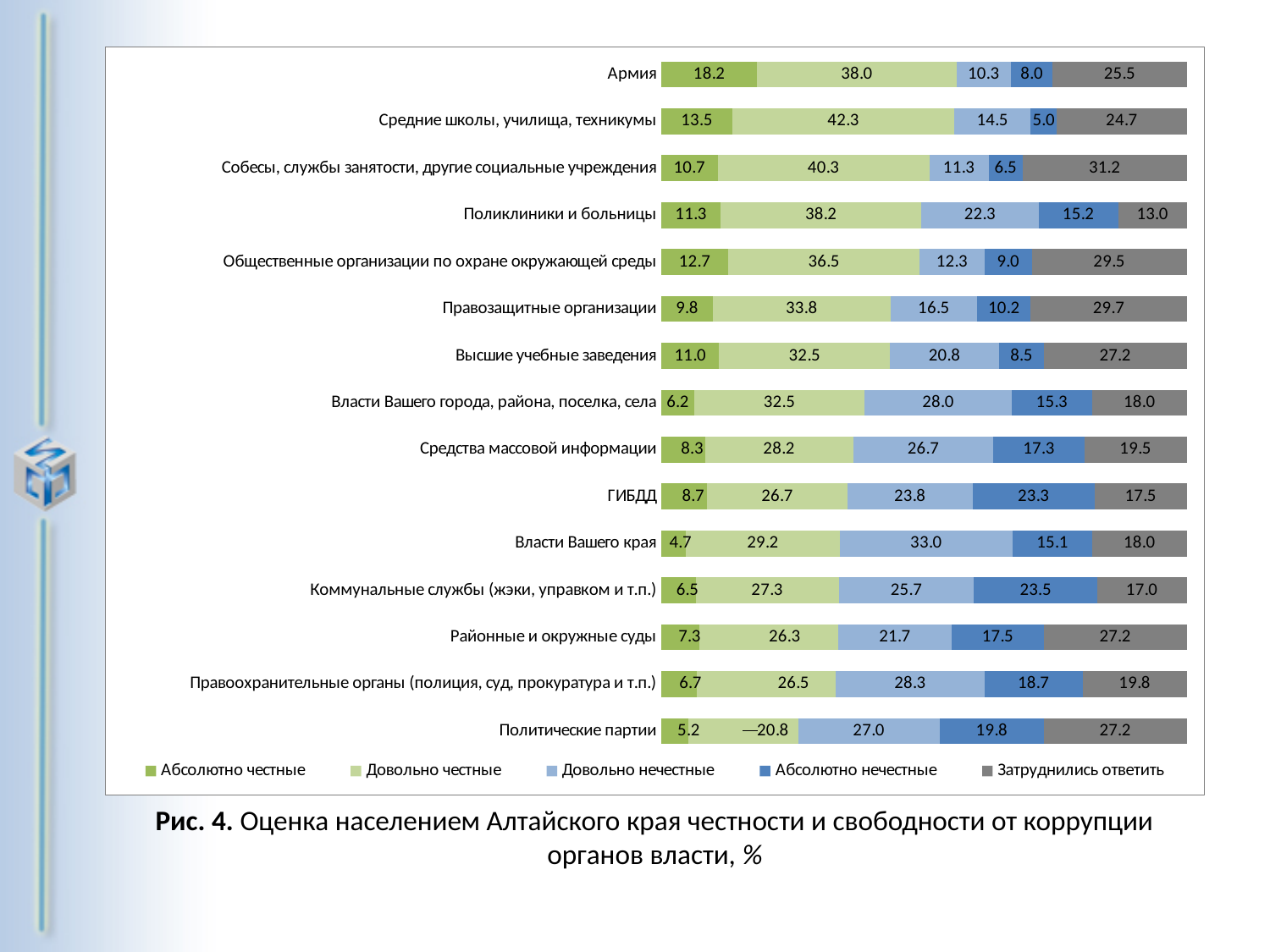
What is the value of 'Довольно нечестные' for Власти Вашего края? 33.0 What is the value of 'Затруднились ответить' for Поликлиники и больницы? 13.0 What kind of chart is shown on the slide? stacked bar chart Which category has the lowest value for 'Абсолютно честные'? Власти Вашего края What is the value of 'Абсолютно честные' for Армия? 18.2 What is the difference between the 'Довольно честные' values for Средние школы, училища, техникумы and Политические партии? 21.5 How many series does the legend list? 5 How many categories (institutions) are shown in the chart? 15 Which category has the highest value for 'Абсолютно честные'? Армия Which category has the highest value for 'Затруднились ответить'? Собесы, службы занятости, другие социальные учреждения Which is larger: the 'Абсолютно нечестные' value for ГИБДД or for Армия? ГИБДД Which category has the highest value for 'Довольно честные'? Средние школы, училища, техникумы